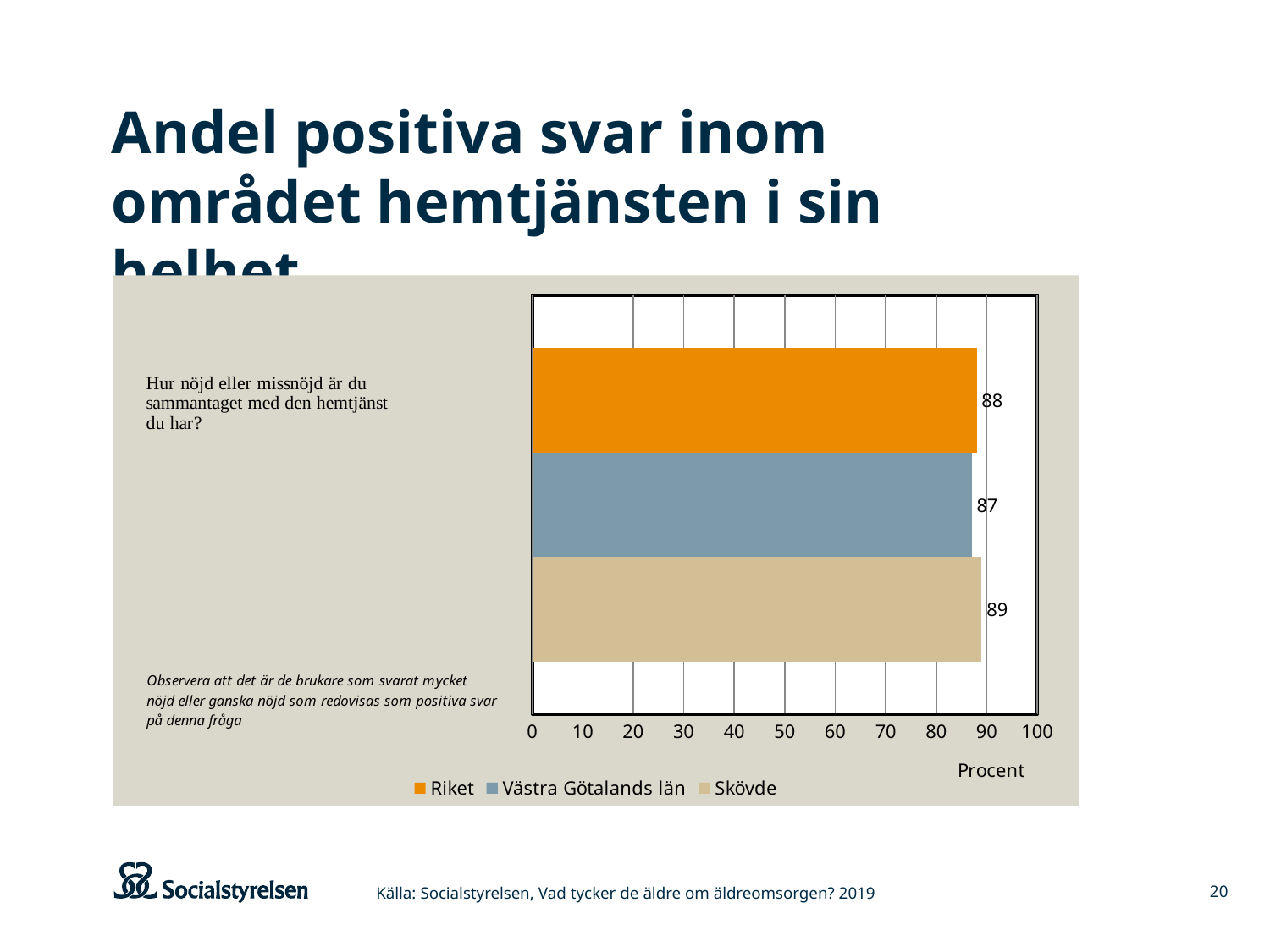
What is the value for Västra Götalands län? 87 What is the difference between the values for Riket and Västra Götalands län? 1 What is the label on the horizontal axis? Procent Which series has the highest value? Skövde Which series has the lowest value? Västra Götalands län What is the difference between the values for Skövde and Västra Götalands län? 2 Is the value for Riket greater or less than 80? greater Which is larger, the value for Skövde or the value for Riket? Skövde What is the value for Riket? 88 What is the value for Skövde? 89 What kind of chart is shown on the slide? bar chart How many series does the legend list? 3